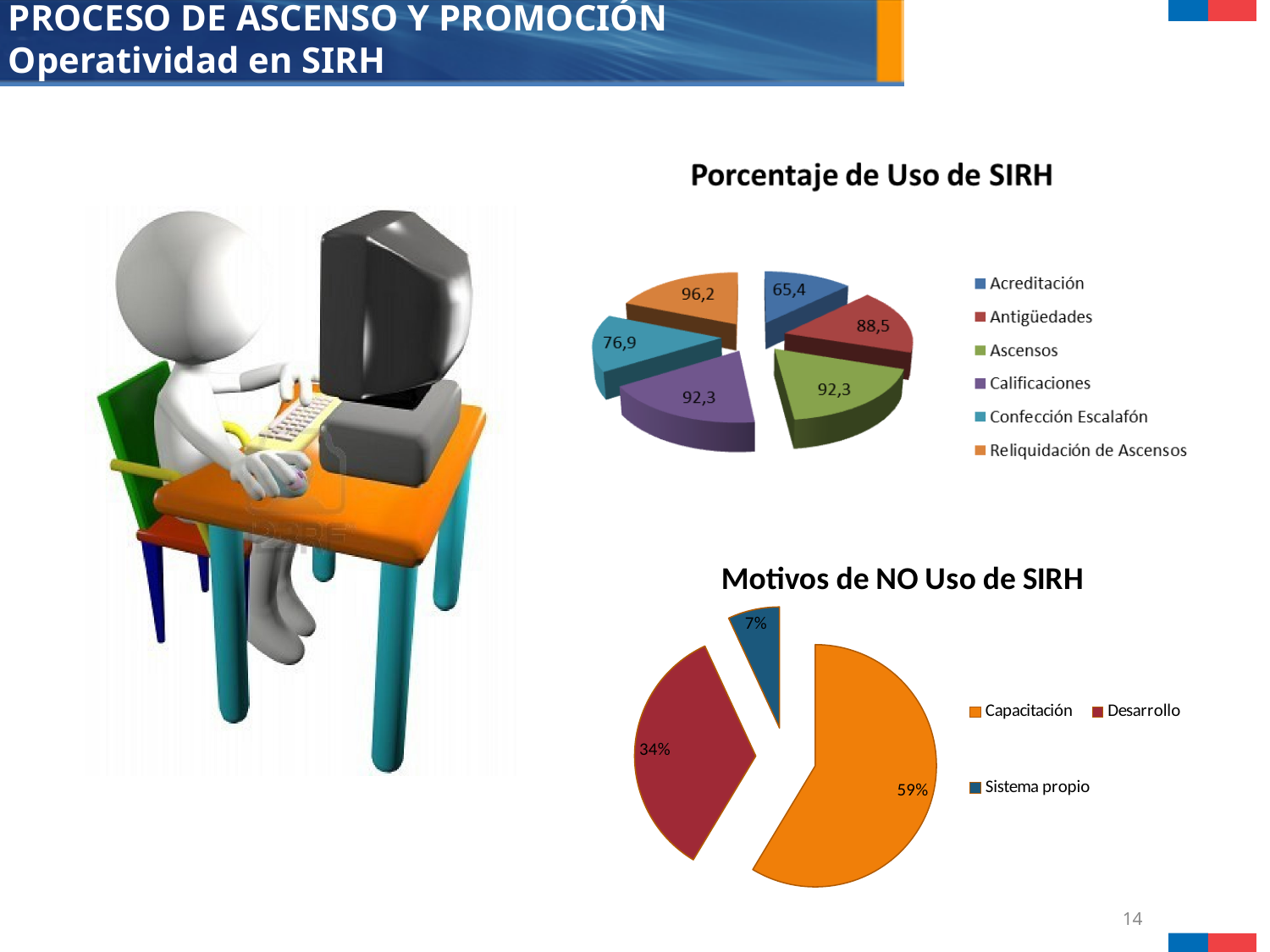
In the 'Motivos de NO Uso de SIRH' chart, which category has the smallest slice? Sistema propio In the 'Porcentaje de Uso de SIRH' chart, what is the value for Acreditación? 65,4 How many categories does the 'Porcentaje de Uso de SIRH' chart show? 6 In the 'Motivos de NO Uso de SIRH' chart, what is the difference between Capacitación and Desarrollo? 25% In the 'Porcentaje de Uso de SIRH' chart, what is the value for Antigüedades? 88,5 In the 'Porcentaje de Uso de SIRH' chart, what is the difference between Reliquidación de Ascensos and Acreditación? 30,8 What type of chart is 'Motivos de NO Uso de SIRH'? Pie chart In the 'Porcentaje de Uso de SIRH' chart, which category has the lowest value? Acreditación In the 'Porcentaje de Uso de SIRH' chart, which is larger, Antigüedades or Confección Escalafón? Antigüedades In the 'Porcentaje de Uso de SIRH' chart, what is the value for Confección Escalafón? 76,9 In the 'Motivos de NO Uso de SIRH' chart, what share does Desarrollo have? 34% In the 'Porcentaje de Uso de SIRH' chart, which category has the highest value? Reliquidación de Ascensos